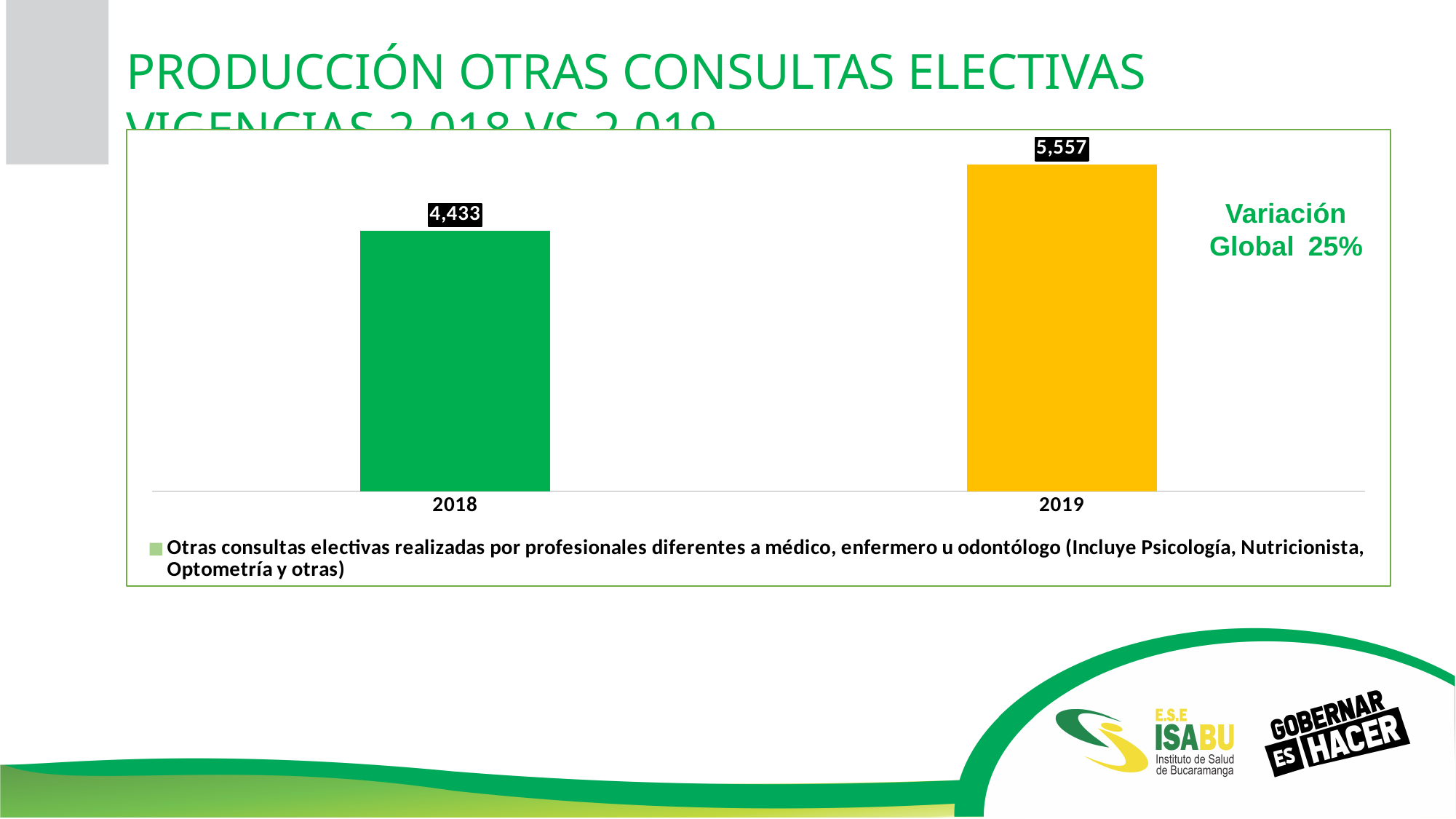
Which year has the lowest value? 2018 Which year has the highest value? 2019 What is the value for 2019? 5,557 How many series does the legend list? 1 What kind of chart is shown? bar chart Do the values rise or fall from 2018 to 2019? rise What is the value for 2018? 4,433 What colour is the bar for 2019? yellow What is the difference between the 2019 and 2018 values? 1,124 What global variation percentage is stated next to the chart? 25% Which is larger, the value for 2018 or the value for 2019? 2019 How many categories are shown on the x axis? 2